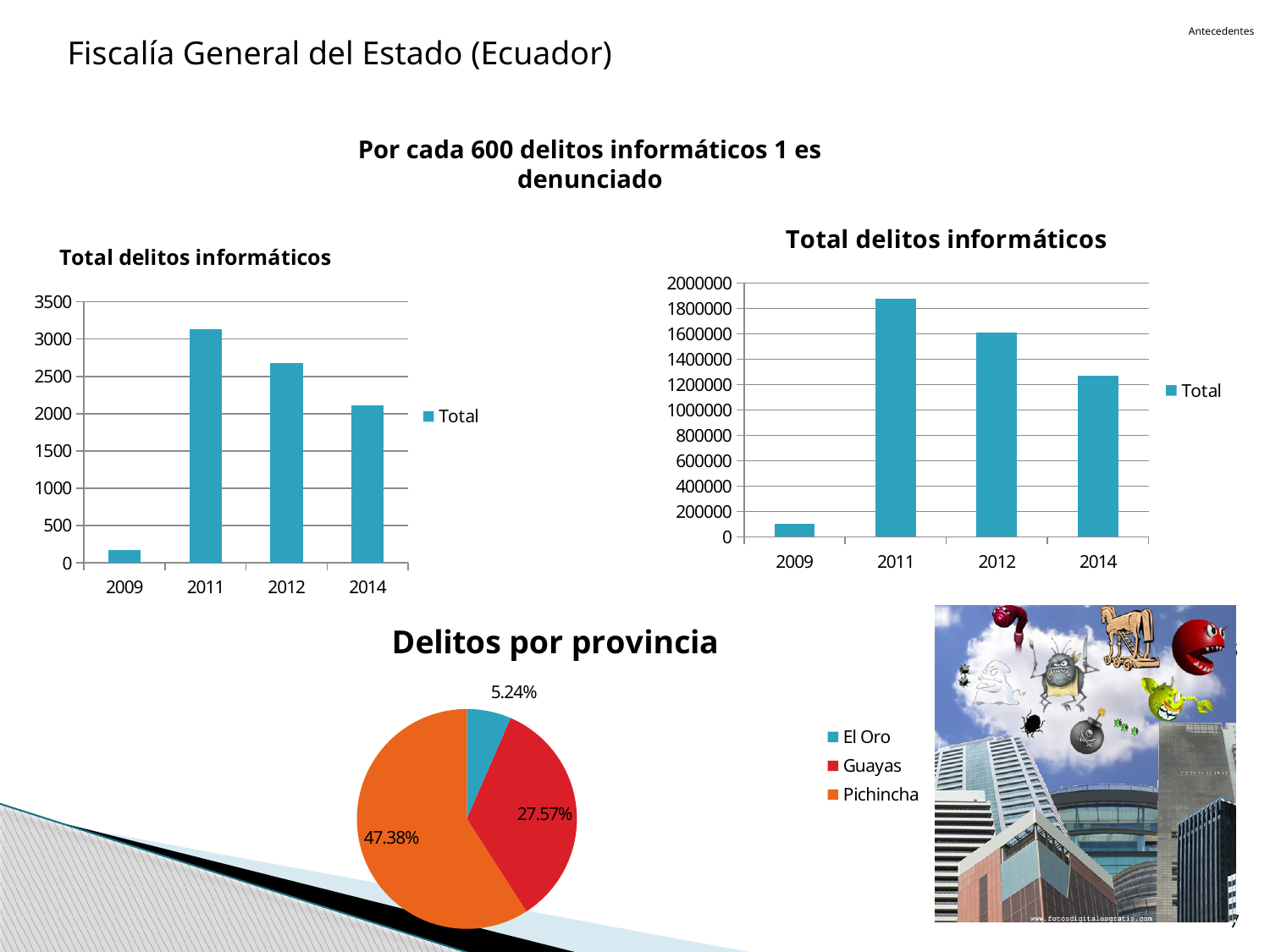
In the pie chart titled 'Delitos por provincia', how many provinces does the legend list? 3 In the right bar chart titled 'Total delitos informáticos', which is larger, the value for 2012 or the value for 2014? 2012 In the right bar chart titled 'Total delitos informáticos', is the value for 2014 greater or less than 1400000? less In the pie chart titled 'Delitos por provincia', what share does Guayas have? 27.57% In the left bar chart titled 'Total delitos informáticos', which year has the lowest value? 2009 In the pie chart titled 'Delitos por provincia', what share does Pichincha have? 47.38% In the left bar chart titled 'Total delitos informáticos', which year has the highest value? 2011 In the pie chart titled 'Delitos por provincia', what share does El Oro have? 5.24% In the pie chart titled 'Delitos por provincia', which province has the largest slice? Pichincha In the left bar chart titled 'Total delitos informáticos', is the value for 2012 greater or less than 2500? greater In the pie chart titled 'Delitos por provincia', how many percentage points larger is Pichincha's share than Guayas's share? 19.81% In the pie chart titled 'Delitos por provincia', which province has the smallest slice? El Oro